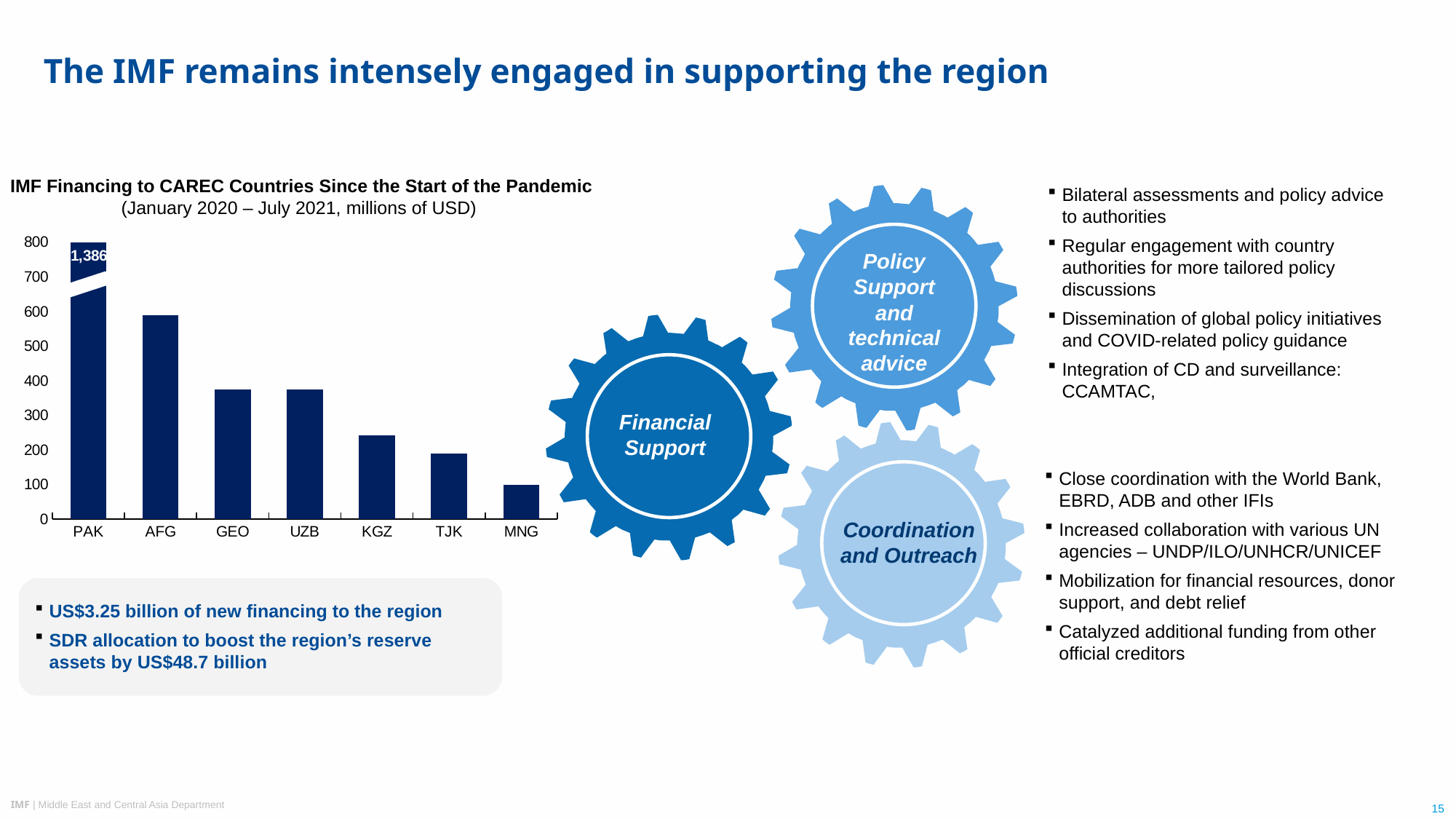
Which received more IMF financing, AFG or KGZ? AFG How many countries are shown on the x axis of the chart? 7 What kind of chart is used to show IMF financing to CAREC countries? bar chart What period does the chart cover, according to its subtitle? January 2020 – July 2021 Is the value for AFG greater or less than 500? greater In what units are the chart values expressed? millions of USD What value is printed on the PAK bar in the IMF Financing to CAREC Countries chart? 1,386 Is the value for MNG greater or less than 200? less Which country received the most IMF financing according to the chart? PAK Is the value for KGZ greater or less than 300? less Do the bar values rise or fall moving from PAK to MNG along the x axis? fall Which country received the least IMF financing according to the chart? MNG